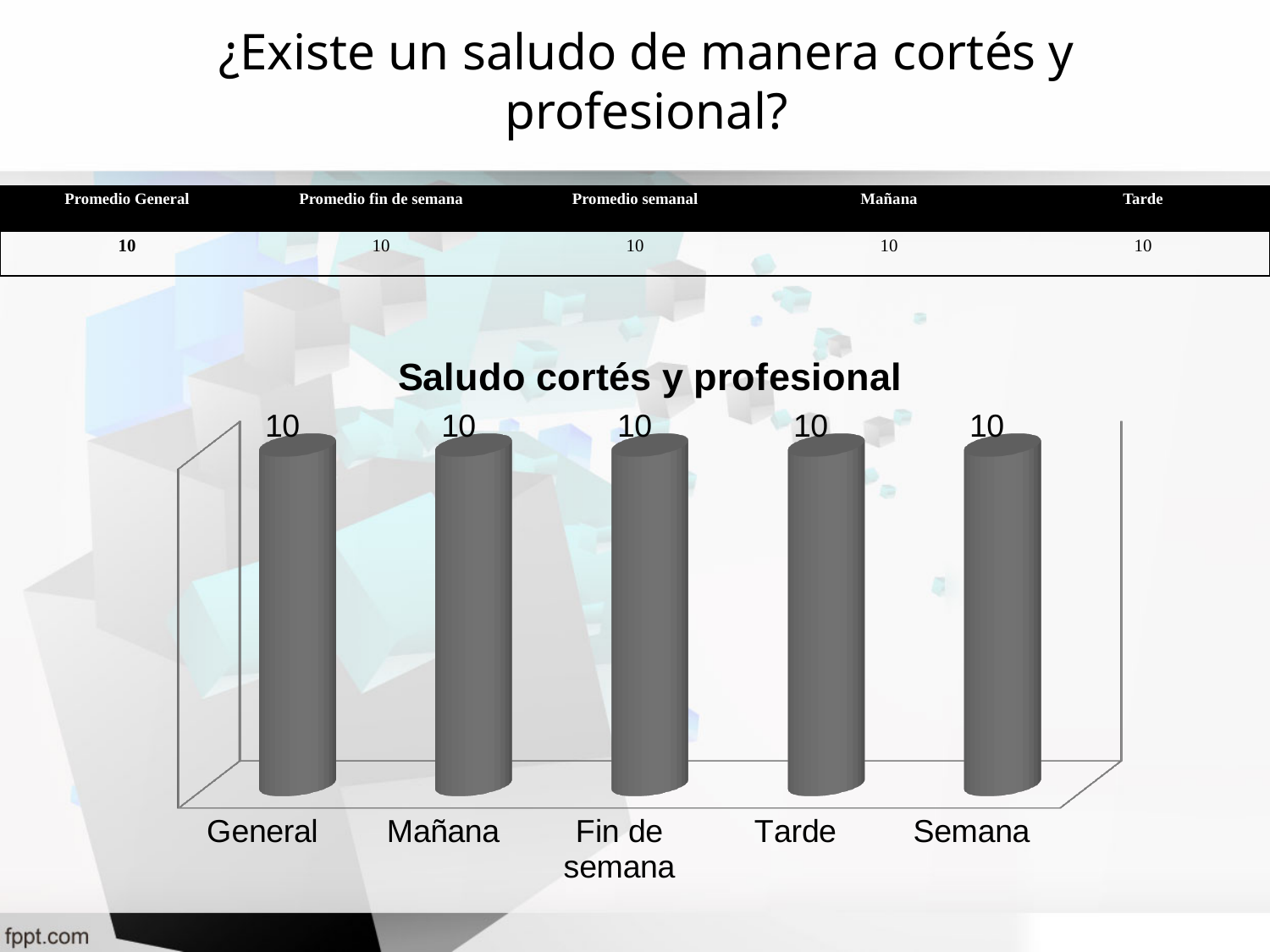
Do the values rise, fall, or stay the same across the categories in the Saludo cortés y profesional chart? stay the same What kind of chart is the Saludo cortés y profesional chart? bar chart What is the value for Mañana in the Saludo cortés y profesional chart? 10 What is the value for Semana in the Saludo cortés y profesional chart? 10 Is the value for Mañana larger than, smaller than, or equal to the value for Semana in the Saludo cortés y profesional chart? equal What is the label of the third category from the left in the Saludo cortés y profesional chart? Fin de semana What is the value for Fin de semana in the Saludo cortés y profesional chart? 10 How many categories are shown in the Saludo cortés y profesional chart? 5 What is the value for General in the Saludo cortés y profesional chart? 10 What is the value for Tarde in the Saludo cortés y profesional chart? 10 What is the difference between the values for General and Tarde in the Saludo cortés y profesional chart? 0 What is the title of the chart on the slide? Saludo cortés y profesional